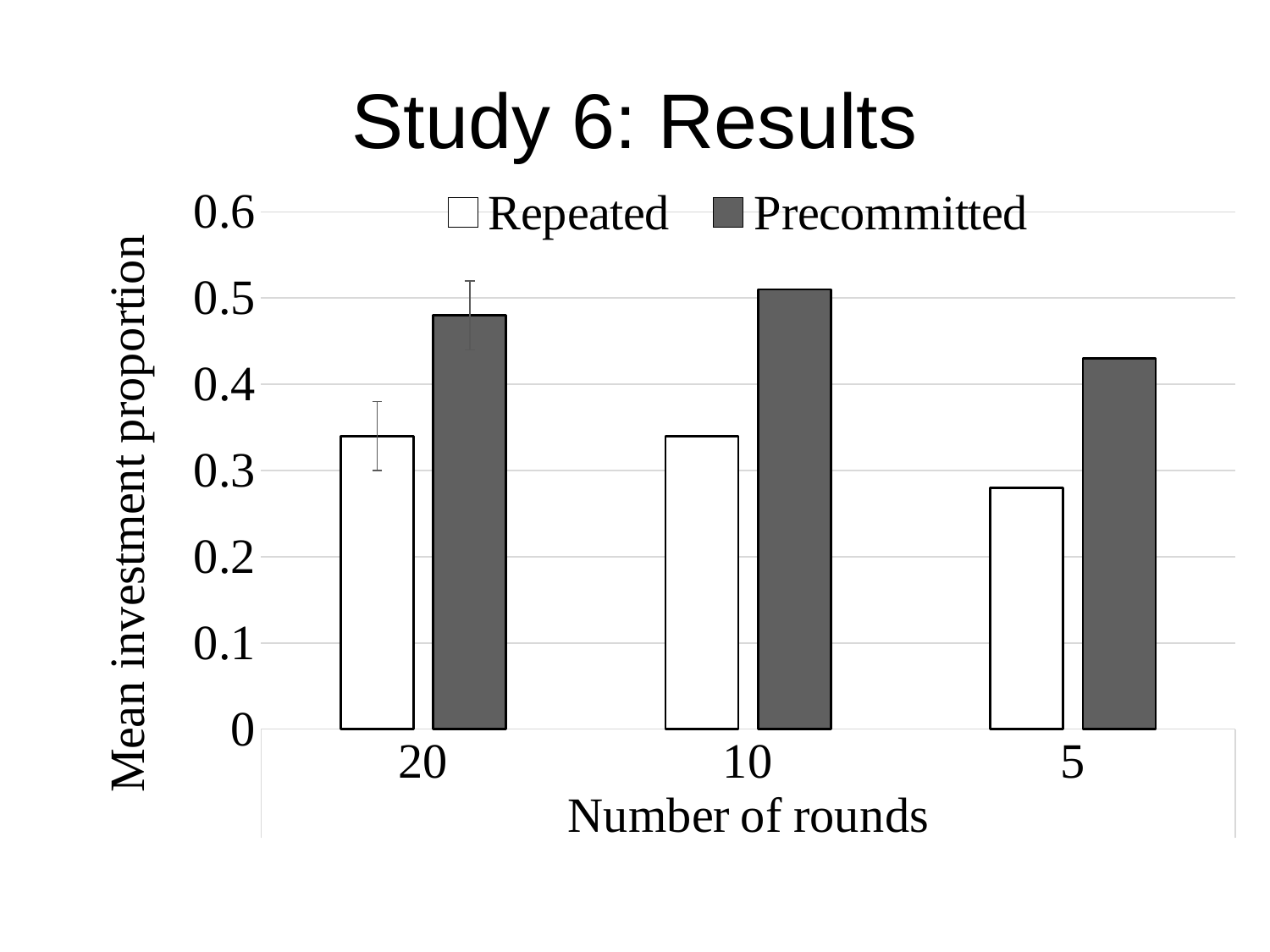
What kind of chart is shown on the slide? Bar chart How many categories are shown on the x axis? 3 Is the Repeated value for 5 rounds greater or less than 0.3? less What is the label of the y axis? Mean investment proportion For which number of rounds is the Repeated value lowest? 5 Is the Precommitted value for 5 rounds greater or less than 0.4? greater How many series does the legend list? 2 Is the Repeated value for 20 rounds greater or less than 0.3? greater For which number of rounds is the Precommitted value highest? 10 For 5 rounds, which series has the larger value, Repeated or Precommitted? Precommitted